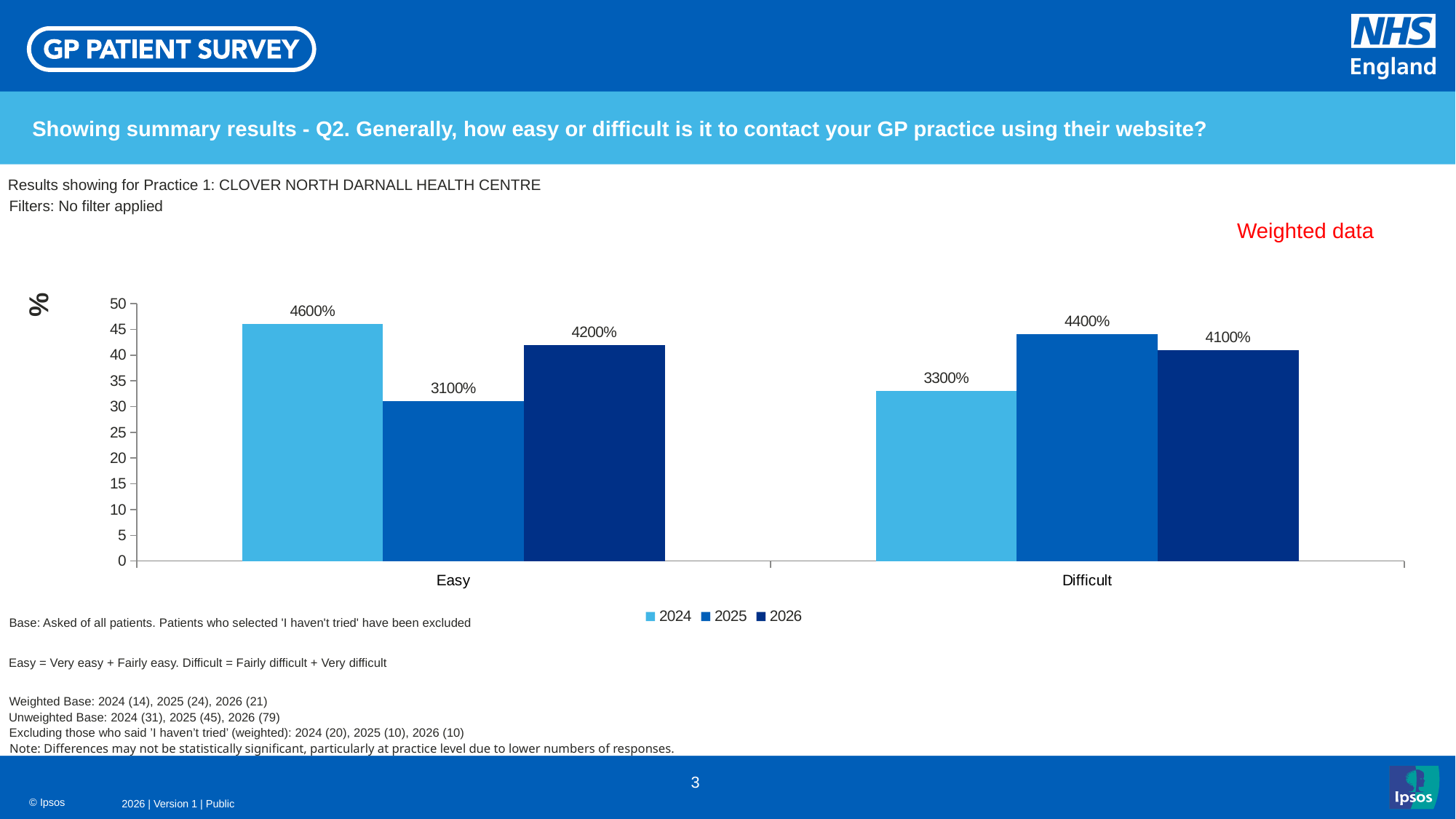
What is the value for 2025 in the Difficult category? 4400% How many categories are shown on the x axis? 2 Which year has the highest value in the Easy category? 2024 Which year has the lowest value in the Difficult category? 2024 Which series is shown in the darkest blue colour? 2026 How many series does the legend list? 3 What kind of chart is shown on the slide? Bar chart What is the value for 2026 in the Difficult category? 4100% Which is larger in the Difficult category: the 2025 value or the 2026 value? 2025 What is the difference between the 2024 and 2025 values in the Easy category, as labelled on the chart? 1500% What is the value for 2024 in the Easy category? 4600% What is the value for 2025 in the Easy category? 3100%